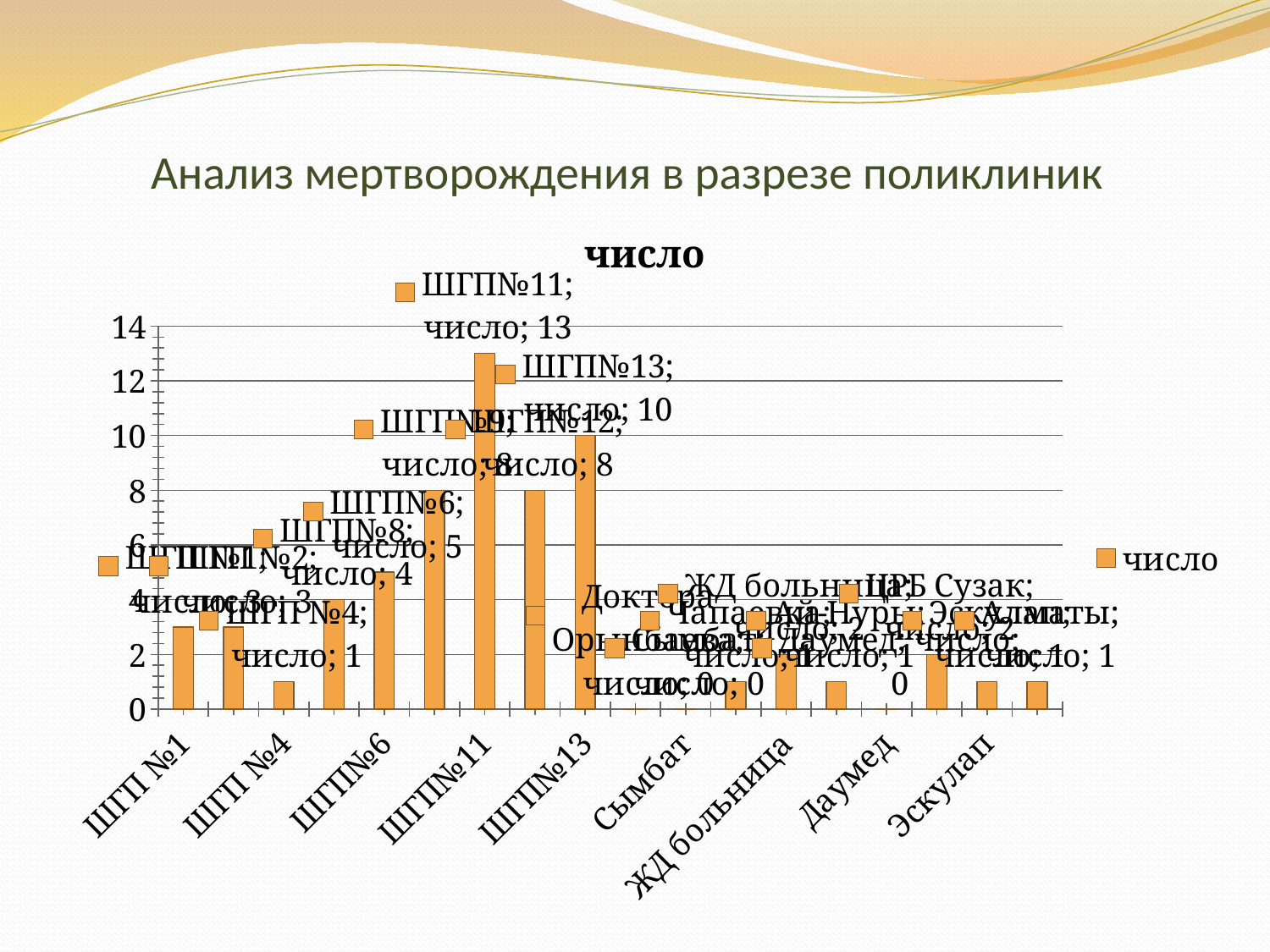
How many series does the legend list? 1 What is the value for ШГП№11? 13 What kind of chart is shown on the slide? bar chart Is the value for ШГП№11 greater or less than 12? greater What is the difference between the values for ШГП№11 and ШГП№13? 3 What is the value for ШГП№6? 5 What is the title of the chart? число What is the value for ШГП№4? 1 What is the value for ШГП№13? 10 Which is larger, the value for ШГП№11 or the value for ШГП№13? ШГП№11 What is the value for ШГП№12? 8 Which category has the highest value? ШГП№11